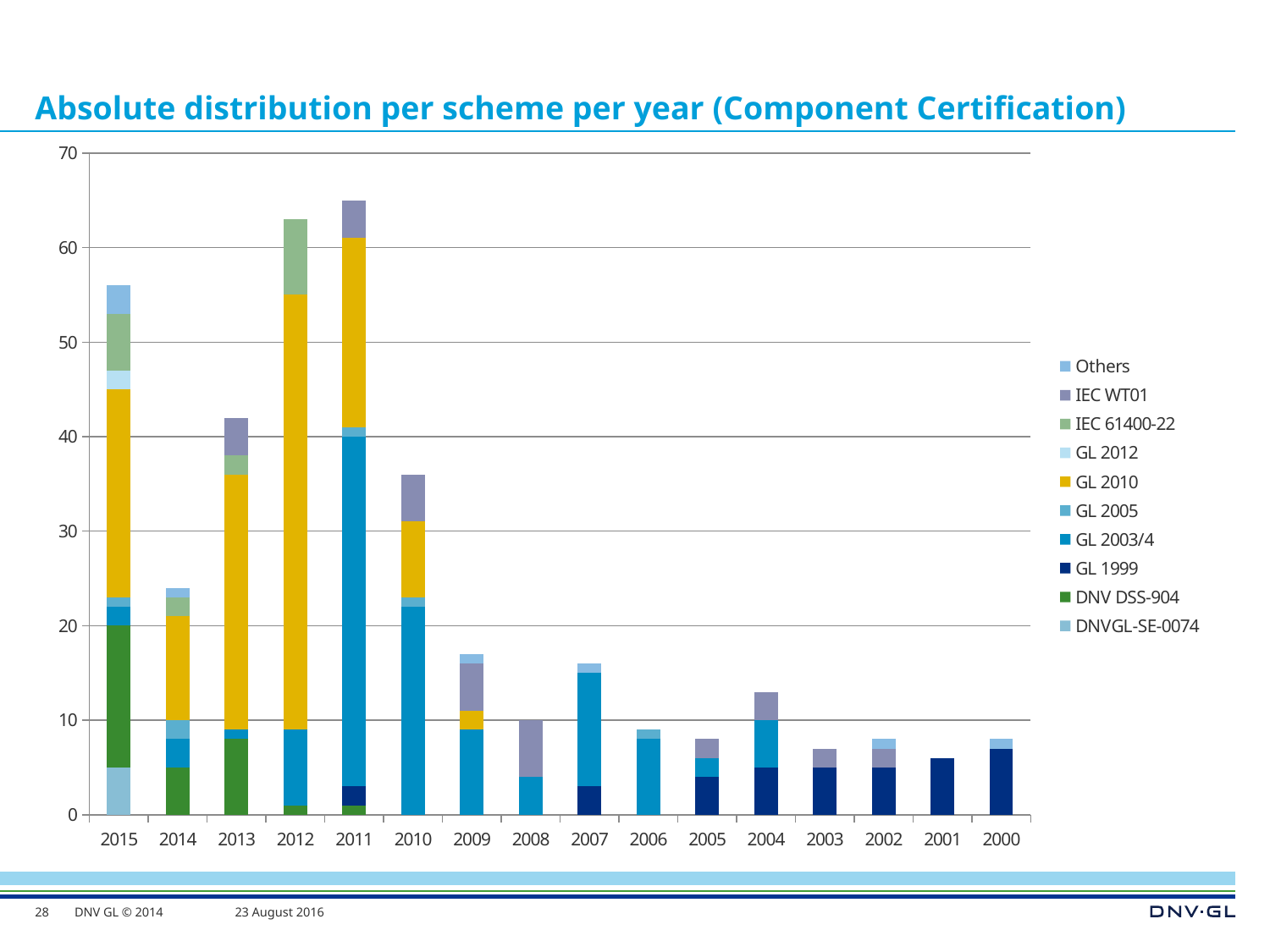
How many series does the legend list? 10 Is the total bar height for 2001 greater or less than 10? less Moving left to right along the x axis from 2015 to 2000, do the total bar heights generally rise or fall? fall Which year has the larger total bar, 2015 or 2014? 2015 What is the title of the chart? Absolute distribution per scheme per year (Component Certification) How many years (categories) are shown along the x axis? 16 Is the total bar height for 2014 greater or less than 20? greater Is the total bar height for 2006 greater or less than 10? less Which year has the larger total bar, 2012 or 2010? 2012 What kind of chart is shown on the slide? Stacked bar chart